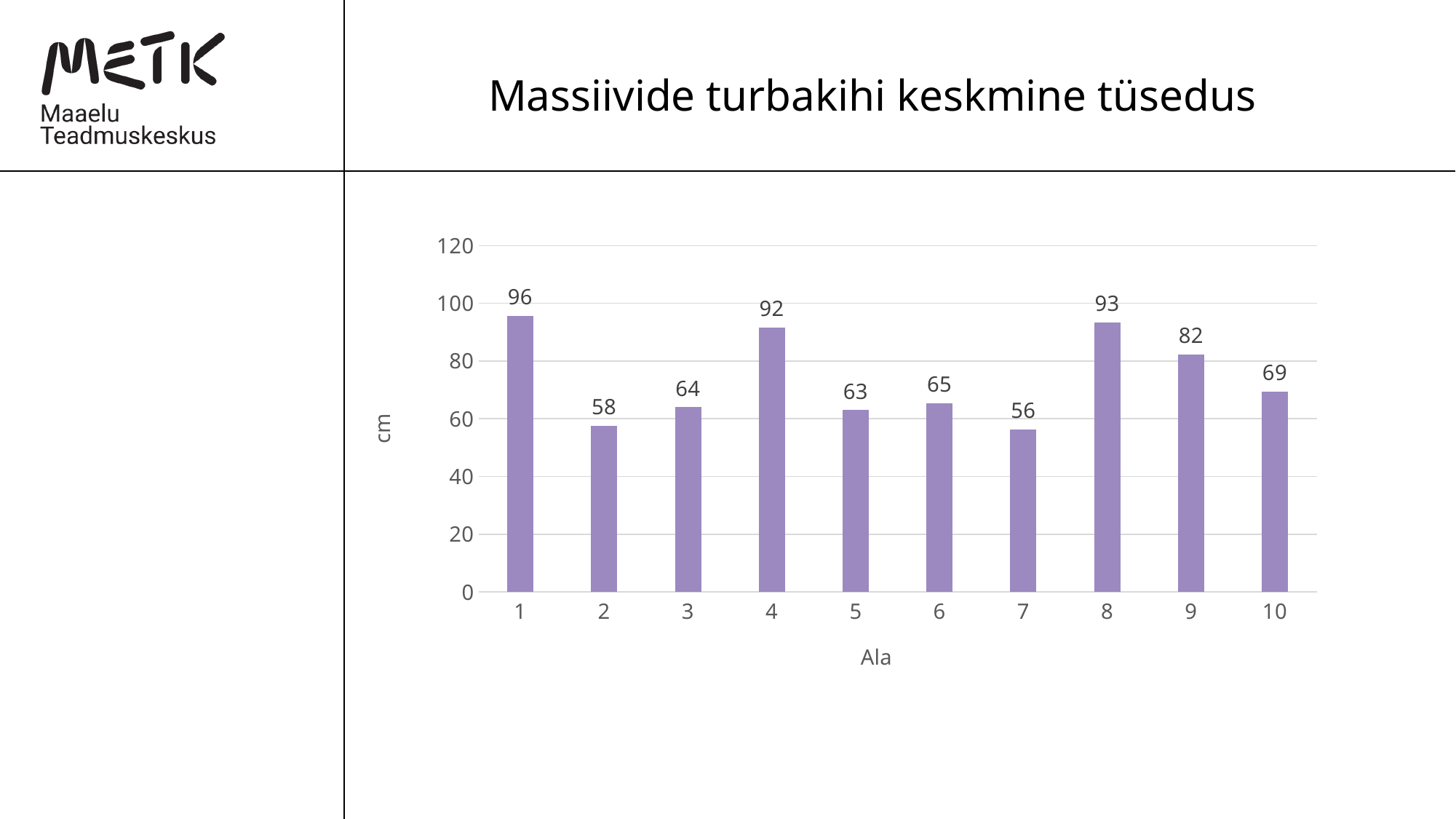
What is the difference between the values for Ala 1 and Ala 7? 40 Which is larger, the value for Ala 4 or the value for Ala 10? Ala 4 What is the value for Ala 7? 56 What is the value for Ala 1? 96 Is the value for Ala 8 greater or less than 80? greater What is the label of the y axis? cm Which Ala has the highest value? 1 What is the value for Ala 9? 82 What kind of chart is shown on the slide? bar chart Which Ala has the lowest value? 7 How many categories (Ala) are shown on the x axis? 10 What is the difference between the values for Ala 8 and Ala 9? 11